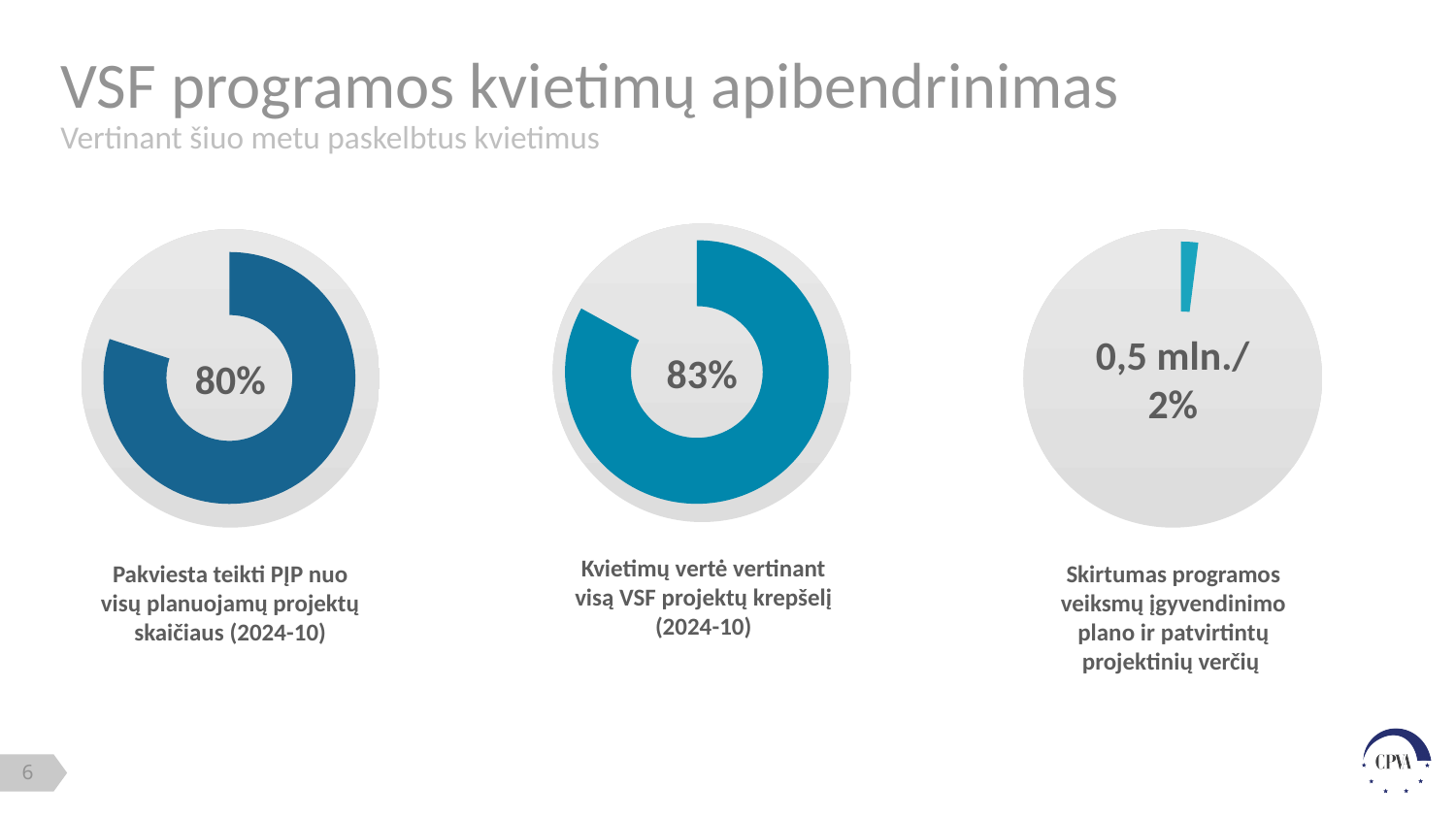
What percentage is shown in the centre of the middle chart (Kvietimų vertė vertinant visą VSF projektų krepšelį)? 83% Is the value shown in the left chart greater or less than 50%? greater What percentage is shown in the centre of the left chart (Pakviesta teikti PĮP nuo visų planuojamų projektų skaičiaus)? 80% What is the difference in percentage points between the middle chart (83%) and the left chart (80%)? 3 percentage points What value is printed in the centre of the right chart (Skirtumas programos veiksmų įgyvendinimo plano ir patvirtintų projektinių verčių)? 0,5 mln./ 2% What is the title of the slide containing the three charts? VSF programos kvietimų apibendrinimas What percentage does the right chart show for the difference between the programme action plan and approved project values? 2% How many circular charts are shown on the slide? 3 Which is larger, the percentage in the left chart or the percentage in the middle chart? middle chart (83%) What kind of chart is used for the three figures on the slide? doughnut (pie) chart Which chart shows the highest percentage: the left, middle or right one? middle Which chart shows the lowest percentage: the left, middle or right one? right